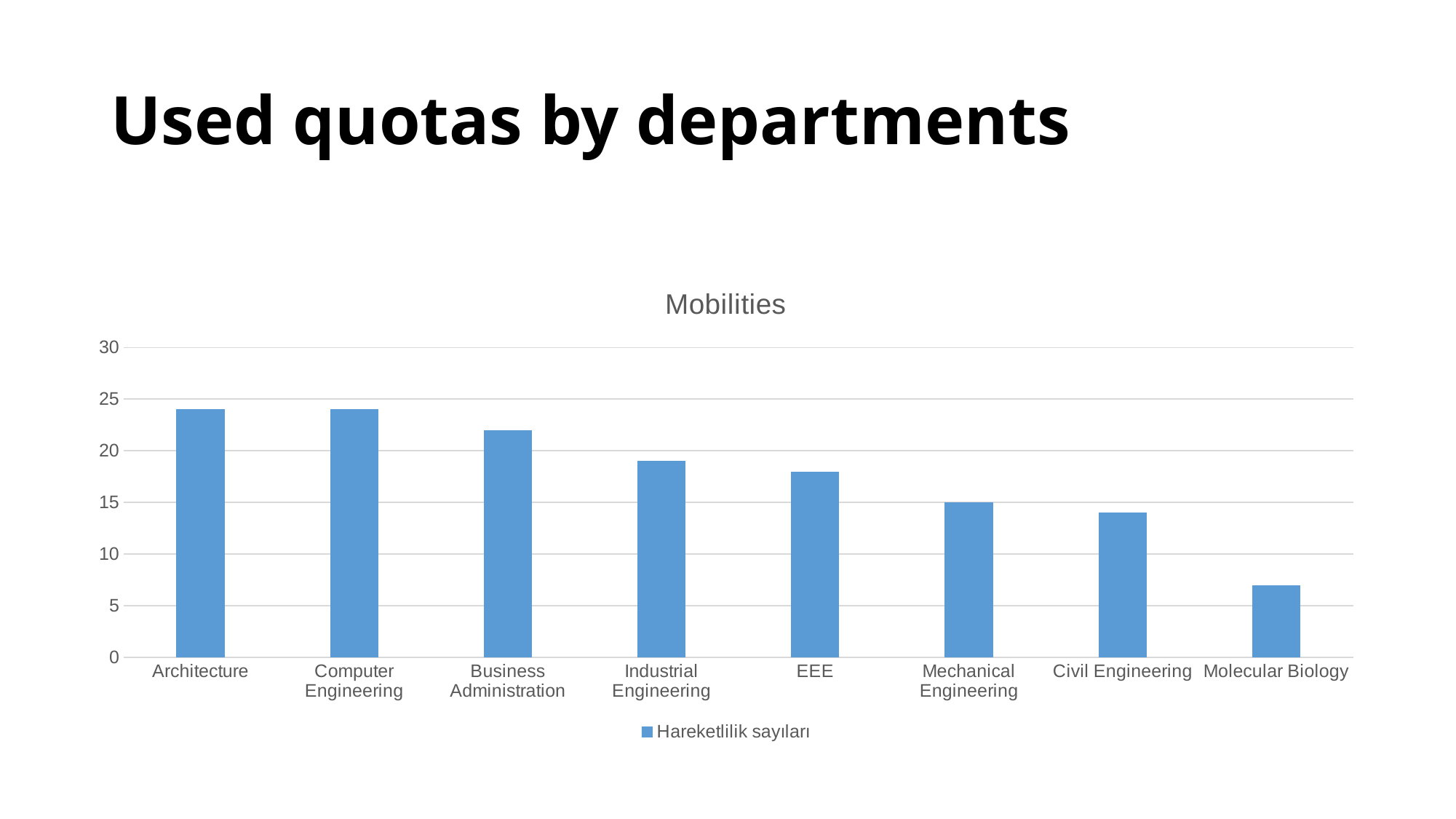
Is the value for Civil Engineering greater or less than 15? less How many departments are shown on the x axis of the chart? 8 Is the value for Molecular Biology greater or less than 10? less How many series does the chart's legend list? 1 Is the value for Architecture greater or less than 20? greater What is the title of the chart? Mobilities Which department has the lowest value in the chart? Molecular Biology Which is larger, the value for Business Administration or the value for EEE? Business Administration Do the values generally rise or fall from left to right along the x axis? fall What kind of chart is shown on the slide? bar chart What is the value for Mechanical Engineering? 15